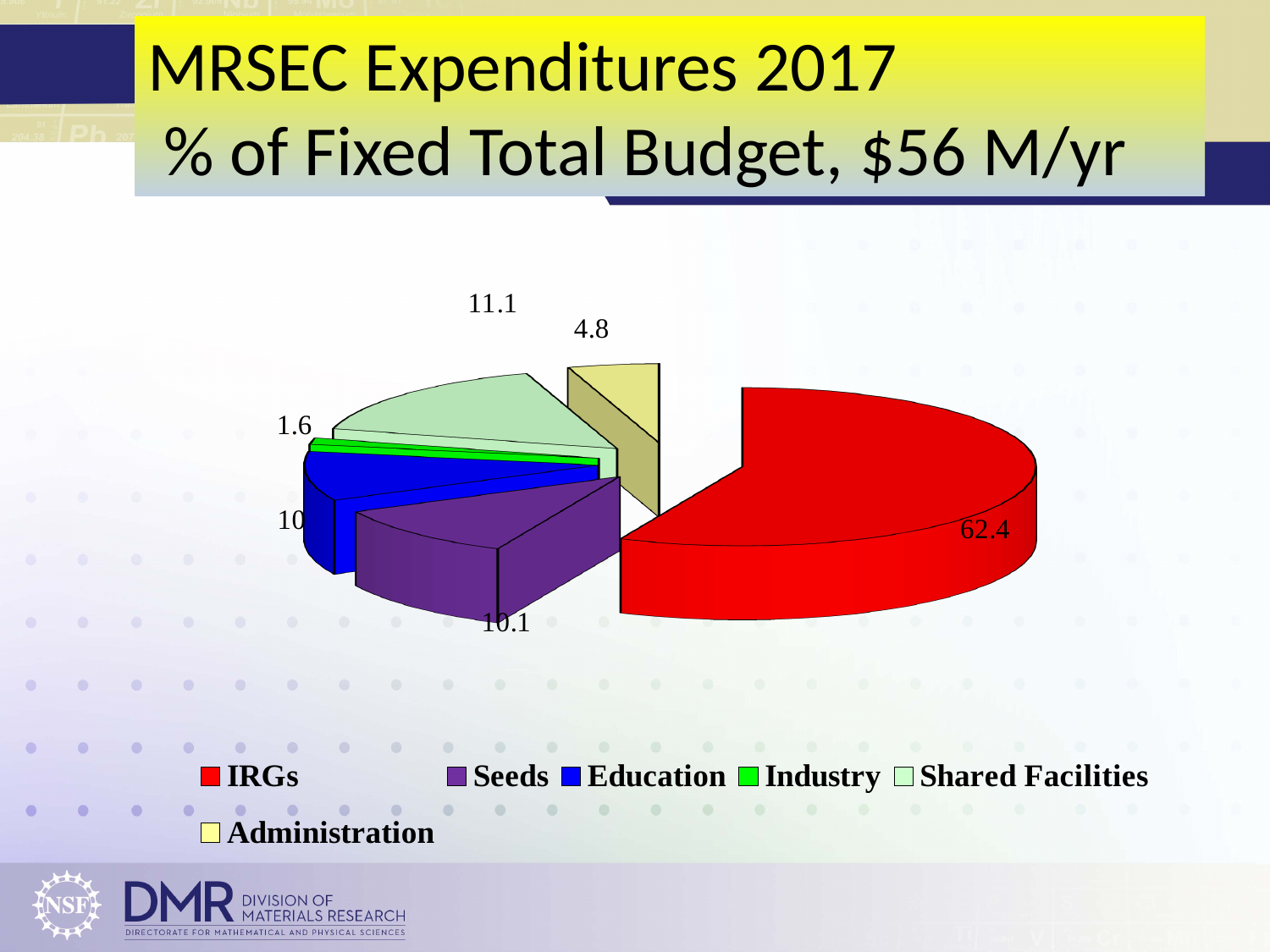
What kind of chart is shown on the slide? pie chart What value is shown for Shared Facilities? 11.1 How many categories does the legend list? 6 What percentage of the budget goes to IRGs? 62.4 Which category has the smallest share of the pie? Industry Which is larger, Shared Facilities or Seeds? Shared Facilities What value is shown for Seeds? 10.1 Which category has the largest share of the pie? IRGs What value is shown for Administration? 4.8 What value is shown for Industry? 1.6 What colour is the IRGs slice? red What is the difference between the IRGs value and the Shared Facilities value? 51.3